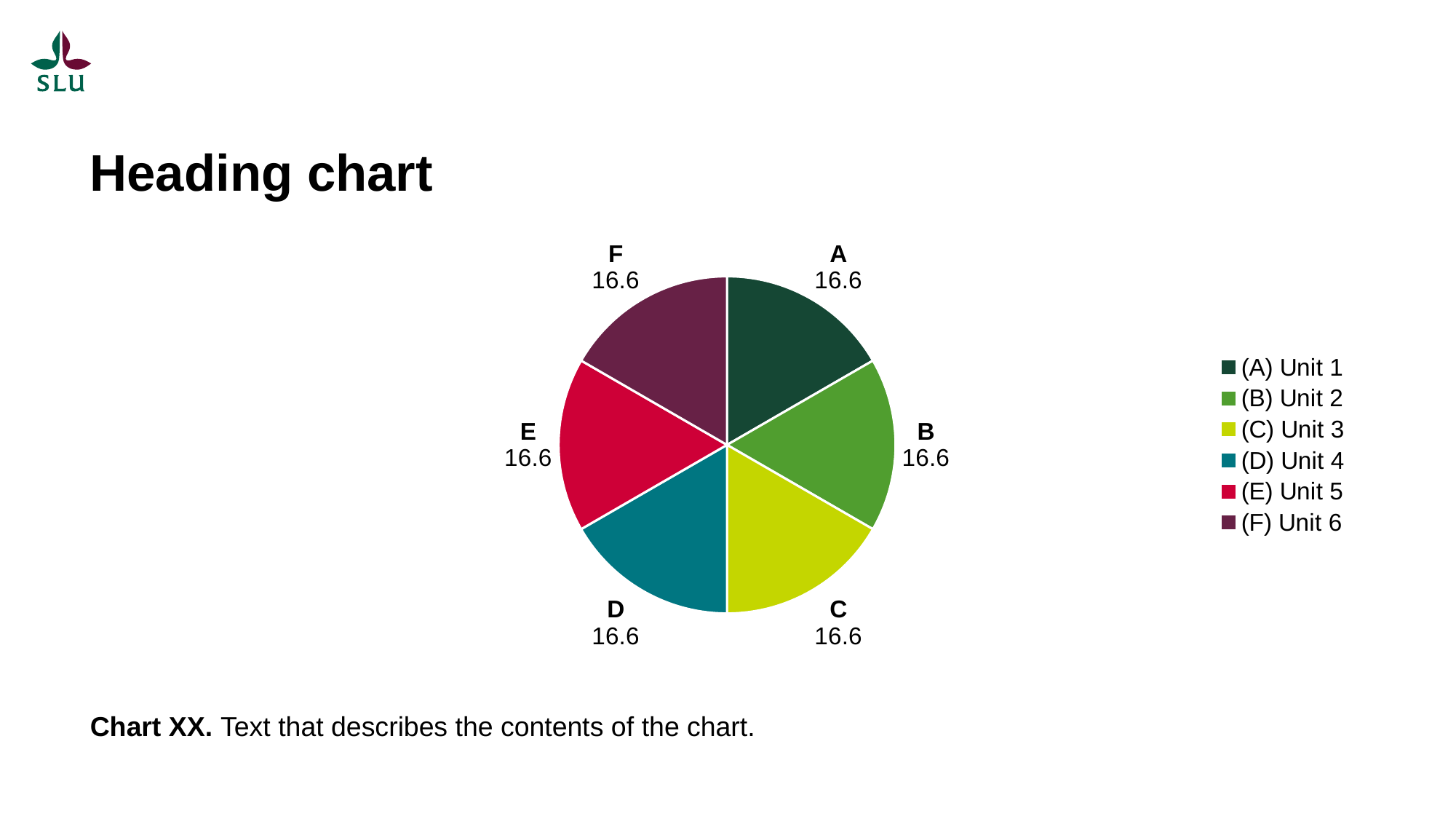
What kind of chart is shown on the slide? Pie chart What is the value shown for slice C? 16.6 How many entries does the legend list? 6 What is the title of the chart on the slide? Heading chart What is the value shown for slice D? 16.6 How many slices does the pie chart have? 6 According to the legend, what label corresponds to slice E? (E) Unit 5 What is the value shown for slice F? 16.6 What is the difference between the values for slice A and slice B? 0 What is the value shown for slice A? 16.6 Do all slices of the pie chart have the same value? Yes